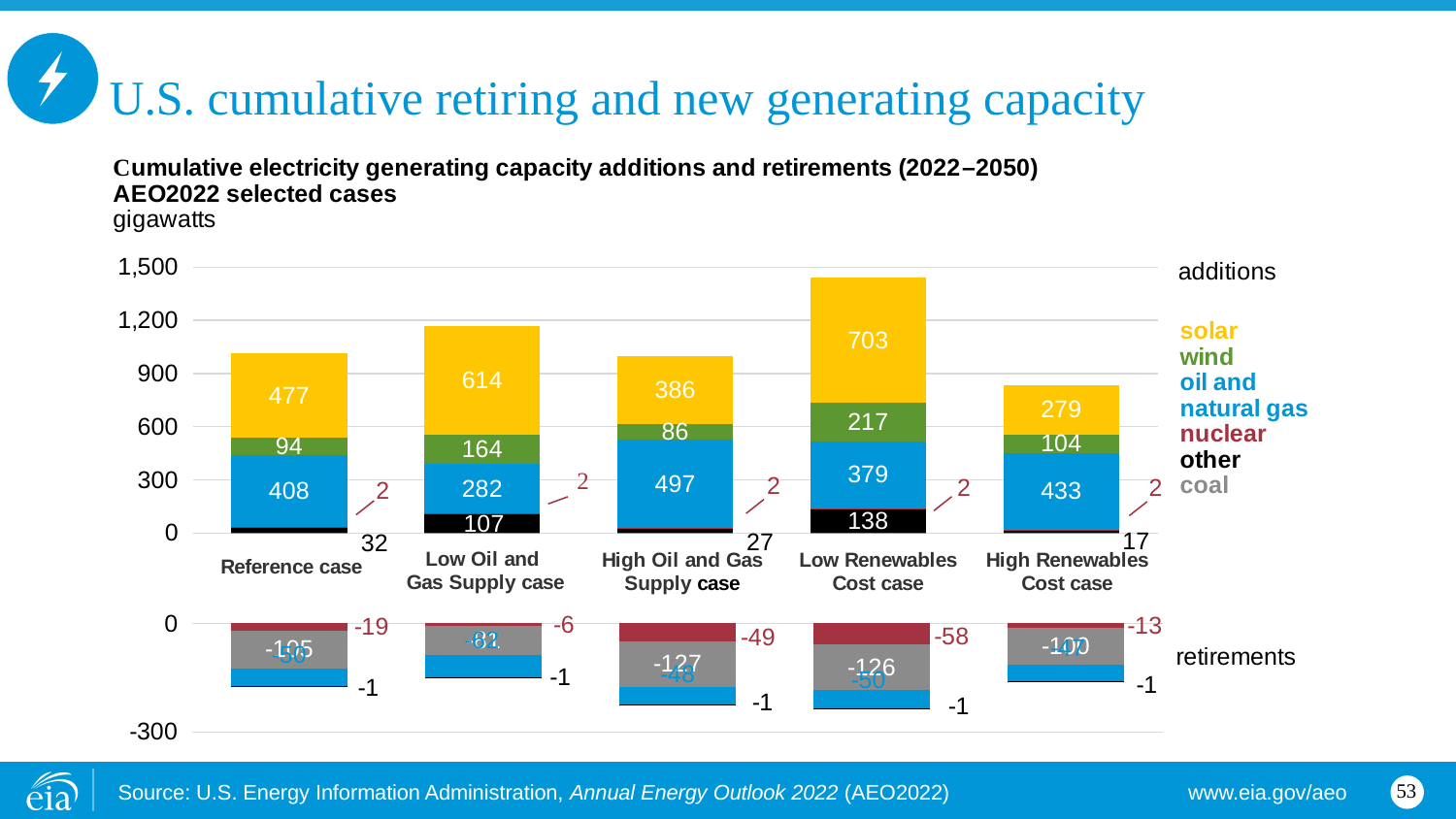
Which has larger wind additions: the Low Renewables Cost case or the Low Oil and Gas Supply case? Low Renewables Cost case Which case has the lowest solar additions? High Renewables Cost case Is the total additions bar for the Low Renewables Cost case greater or less than 1,200 gigawatts? greater Which case has the highest solar additions? Low Renewables Cost case What is the nuclear retirements value for the Low Renewables Cost case? -58 What is the solar additions value for the Low Renewables Cost case? 703 What kind of chart is shown on the slide? Stacked bar chart How many cases are shown on the x axis of the chart? 5 What is the difference between solar additions in the Low Oil and Gas Supply case (614) and the Reference case (477)? 137 What is the oil and natural gas additions value for the High Oil and Gas Supply case? 497 How many fuel categories does the legend list? 6 What is the wind additions value for the Reference case? 94